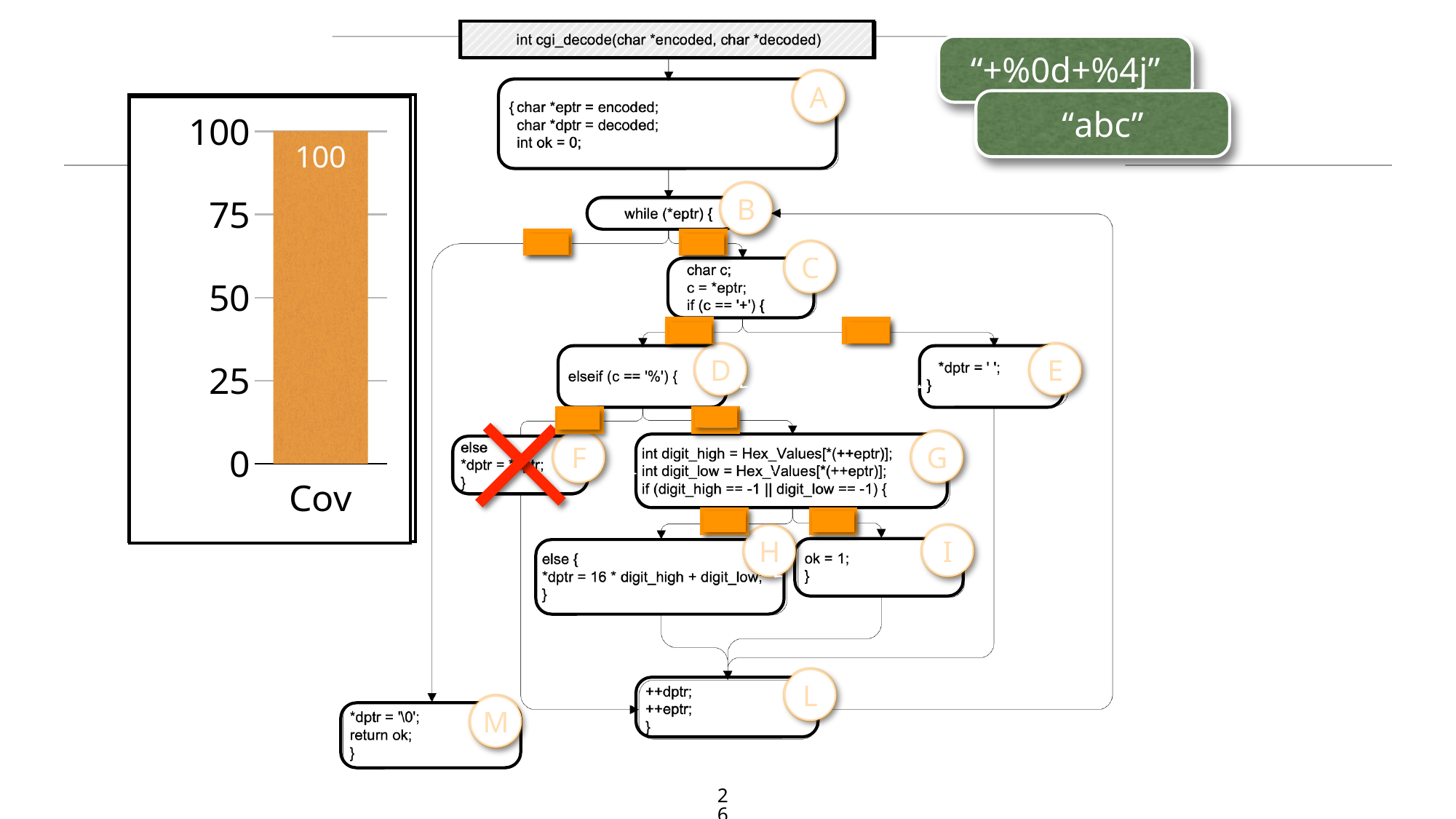
Is the value for Cov greater or less than 50? greater What kind of chart is shown on the left of the slide? bar chart What is the highest tick value shown on the y axis of the bar chart? 100 Does the Cov bar reach the top tick of the y axis? yes What is the category label under the bar in the chart on the left? Cov What is the value of the Cov bar in the bar chart on the left? 100 How many bars does the chart on the left show? 1 Is the value for Cov greater or less than 75? greater